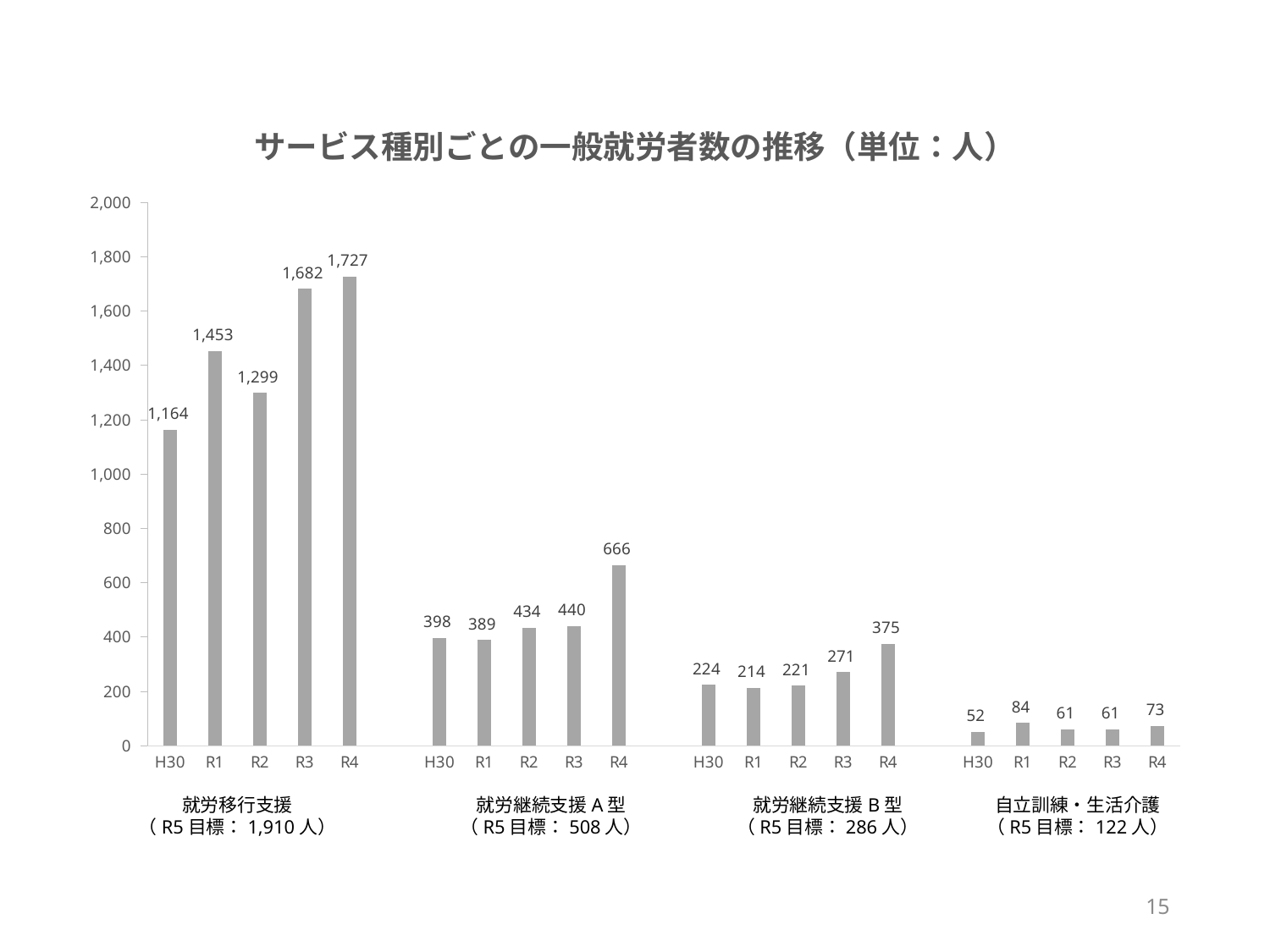
Do the values in the 就労継続支援B型 group rise or fall from R1 to R4? Rise What is the R5 target (R5目標) shown for 就労継続支援A型? 508人 Which year has the highest value in the 就労移行支援 group? R4 What is the value for R4 in the 就労移行支援 group? 1,727 What is the value for H30 in the 就労継続支援A型 group? 398 What is the value for R3 in the 就労継続支援B型 group? 271 Which is larger: the R2 value for 就労移行支援 or the R1 value for 就労移行支援? R1 (1,453) Which year has the lowest value in the 就労継続支援B型 group? R1 What kind of chart is shown on the slide? Bar chart What is the difference between the R4 and R3 values in the 就労継続支援A型 group? 226 How many bars are plotted in the chart in total? 20 What is the value for R1 in the 自立訓練・生活介護 group? 84